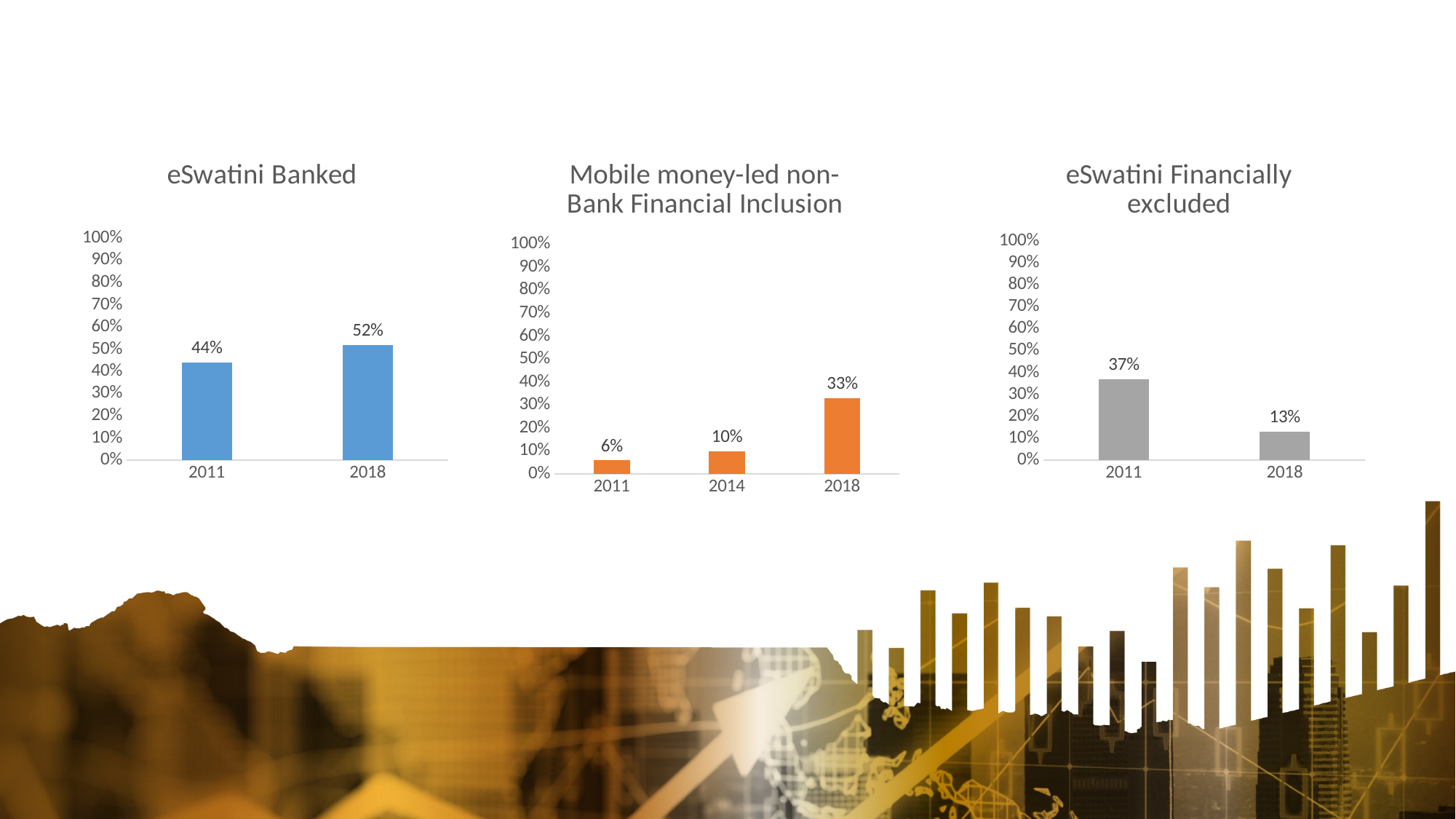
In the 'eSwatini Banked' chart, by how much did the value increase from 2011 to 2018? 8% In the 'Mobile money-led non-Bank Financial Inclusion' chart, what is the difference between the 2018 and 2011 values? 27% In the 'Mobile money-led non-Bank Financial Inclusion' chart, how many years are shown? 3 In the 'eSwatini Financially excluded' chart, which year has the lowest value? 2018 In the 'eSwatini Financially excluded' chart, what is the difference between the 2011 and 2018 values? 24% In the 'eSwatini Financially excluded' chart, what is the value for 2018? 13% In the 'Mobile money-led non-Bank Financial Inclusion' chart, what is the value for 2014? 10% In the 'Mobile money-led non-Bank Financial Inclusion' chart, do the values rise or fall from 2011 to 2018? rise In the 'eSwatini Banked' chart, what is the value for 2018? 52% What type of chart is the 'eSwatini Banked' chart? bar chart In the 'Mobile money-led non-Bank Financial Inclusion' chart, which year has the highest value? 2018 In the 'eSwatini Banked' chart, what is the value for 2011? 44%